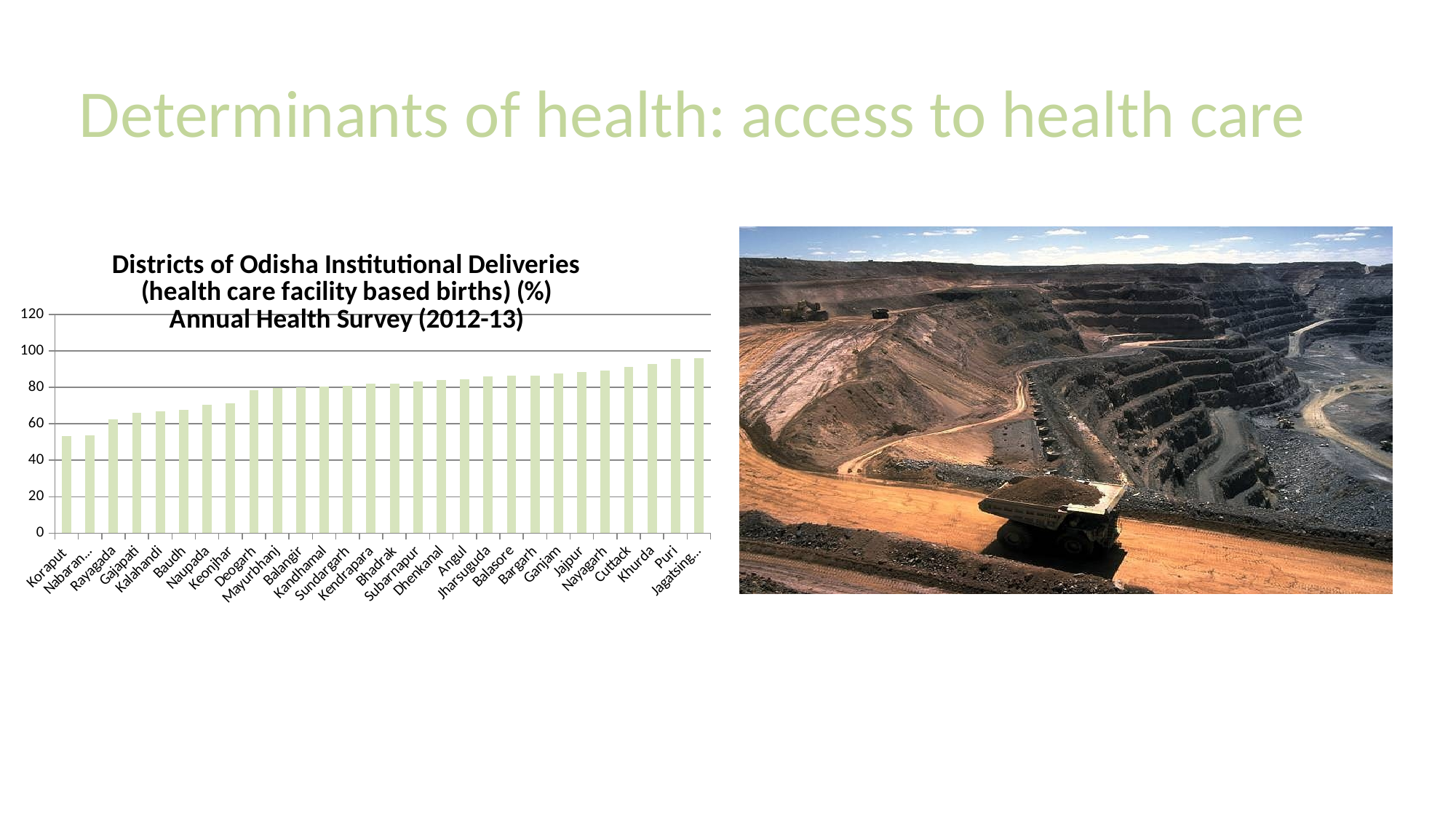
Is the value for Puri greater or less than 80? greater Is the value for Deogarh greater or less than 60? greater Which has the larger value, Koraput or Khurda? Khurda Which survey and year does the chart title cite as the data source? Annual Health Survey (2012-13) Is the value for Cuttack greater or less than 100? less What kind of chart is shown on the slide? bar chart Do the values rise or fall moving from left to right along the x axis? rise How many districts are plotted in the chart? 28 Which has the larger value, Gajapati or Ganjam? Ganjam What is the highest value shown on the chart's vertical axis? 120